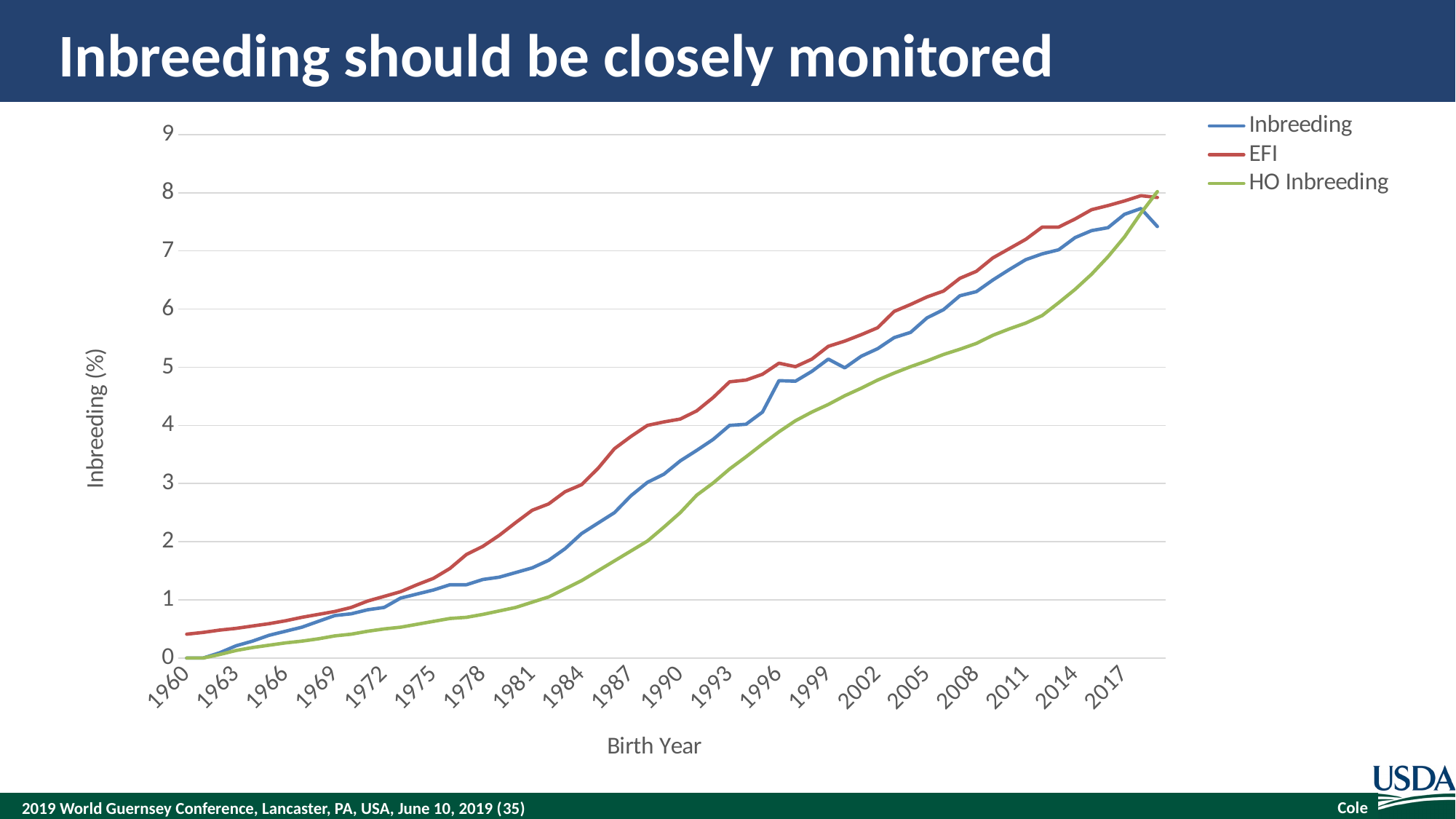
Is the value for HO Inbreeding in 2011 greater or less than 6? less Is the value for HO Inbreeding in 1999 greater or less than 4? greater In 1990, which is higher: EFI or HO Inbreeding? EFI What is the title of the slide's chart? Inbreeding should be closely monitored Does the EFI series generally rise or fall from 1960 to 2017? rise Is the value for Inbreeding in 1978 greater or less than 1? greater How many series does the legend list? 3 Which series has the lowest value in 1990? HO Inbreeding What is the label of the vertical axis? Inbreeding (%) What kind of chart is shown on the slide? line chart